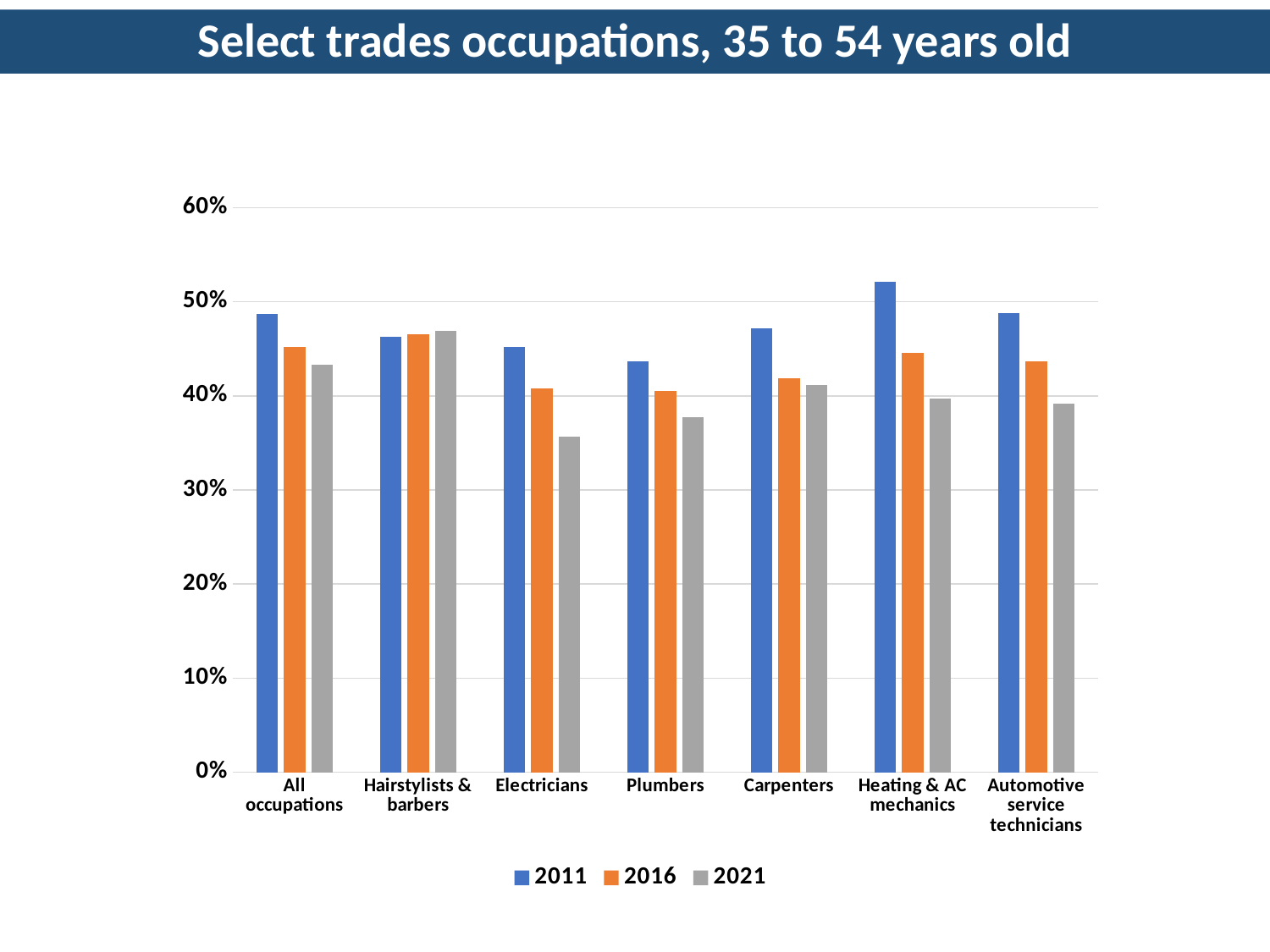
Is the 2011 value for Heating & AC mechanics greater or less than 50%? greater Which occupation has the highest value for 2021? Hairstylists & barbers How many series does the legend list? 3 Is the 2021 value for Plumbers greater or less than 40%? less What kind of chart is shown on the slide? Bar chart For Electricians, which is larger: the 2011 value or the 2021 value? 2011 Is the 2021 value for Electricians greater or less than 40%? less What is the title of the chart? Select trades occupations, 35 to 54 years old Which occupation has the highest value for 2011? Heating & AC mechanics Which occupation has the lowest value for 2021? Electricians For Electricians, do the values rise or fall from 2011 to 2021? fall How many occupation categories are shown on the x axis? 7